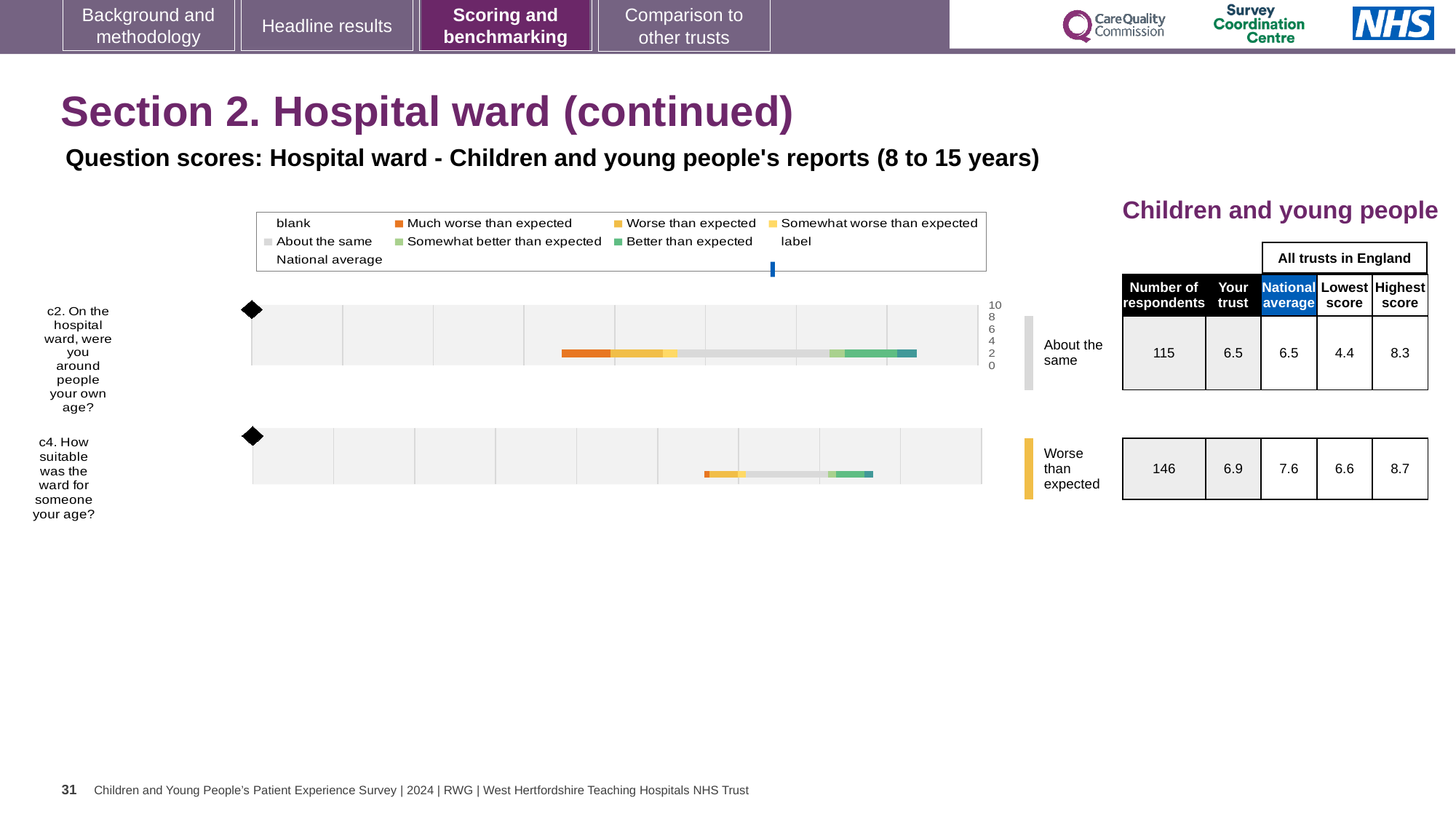
What kind of chart is used to show the question scores for c2 and c4? bar chart What is the highest score among all trusts in England for question c4? 8.7 What is the 'Your trust' score for question c2 (On the hospital ward, were you around people your own age?)? 6.5 What is the difference between the national average and the trust's score for question c4? 0.7 What is the lowest score among all trusts in England for question c2? 4.4 How many questions (c2 and c4) are plotted on the slide? 2 What is the number of respondents for question c2? 115 What benchmark category is question c2 rated as? About the same What is the national average score for question c4? 7.6 What is the 'Your trust' score for question c4 (How suitable was the ward for someone your age?)? 6.9 What benchmark category is question c4 rated as? Worse than expected Which question has the higher 'Your trust' score, c2 or c4? c4